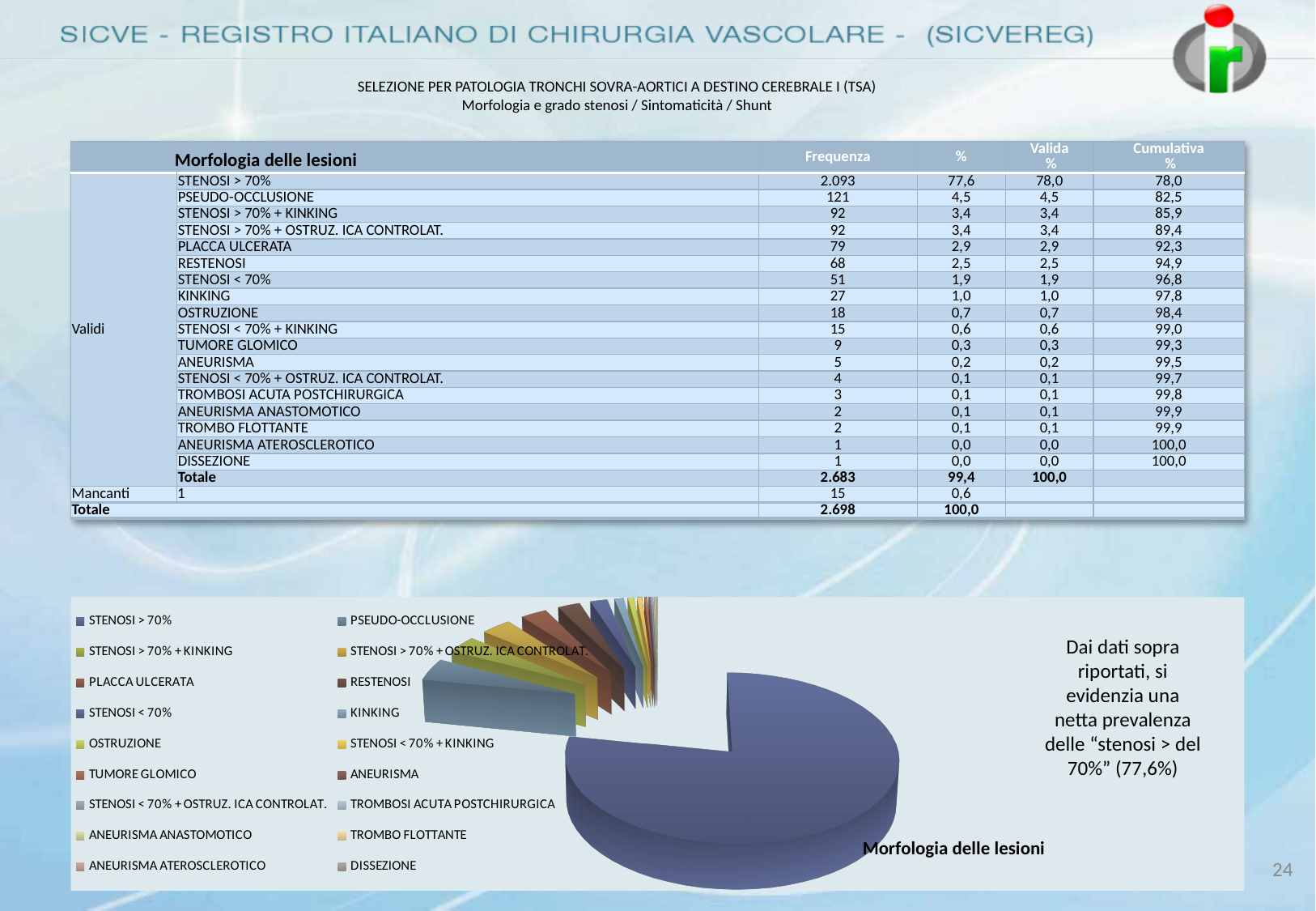
According to the table on the slide, what is the difference in Frequenza between PSEUDO-OCCLUSIONE and STENOSI > 70% + KINKING? 29 Which slice is larger in the pie chart, STENOSI > 70% or PSEUDO-OCCLUSIONE? STENOSI > 70% What share of the pie does the STENOSI > 70% slice represent, according to the slide? 77,6% Which category has the largest slice in the pie chart? STENOSI > 70% According to the table on the slide, what is the Frequenza for STENOSI > 70%? 2.093 According to the table on the slide, what is the Frequenza for PSEUDO-OCCLUSIONE? 121 How many categories does the pie chart's legend list? 18 What kind of chart is shown at the bottom of the slide? pie chart Which is the first category listed in the pie chart's legend? STENOSI > 70% According to the table on the slide, what is the Frequenza for PLACCA ULCERATA? 79 According to the table on the slide, what is the total Frequenza for the Validi rows? 2.683 What is the title of the pie chart? Morfologia delle lesioni